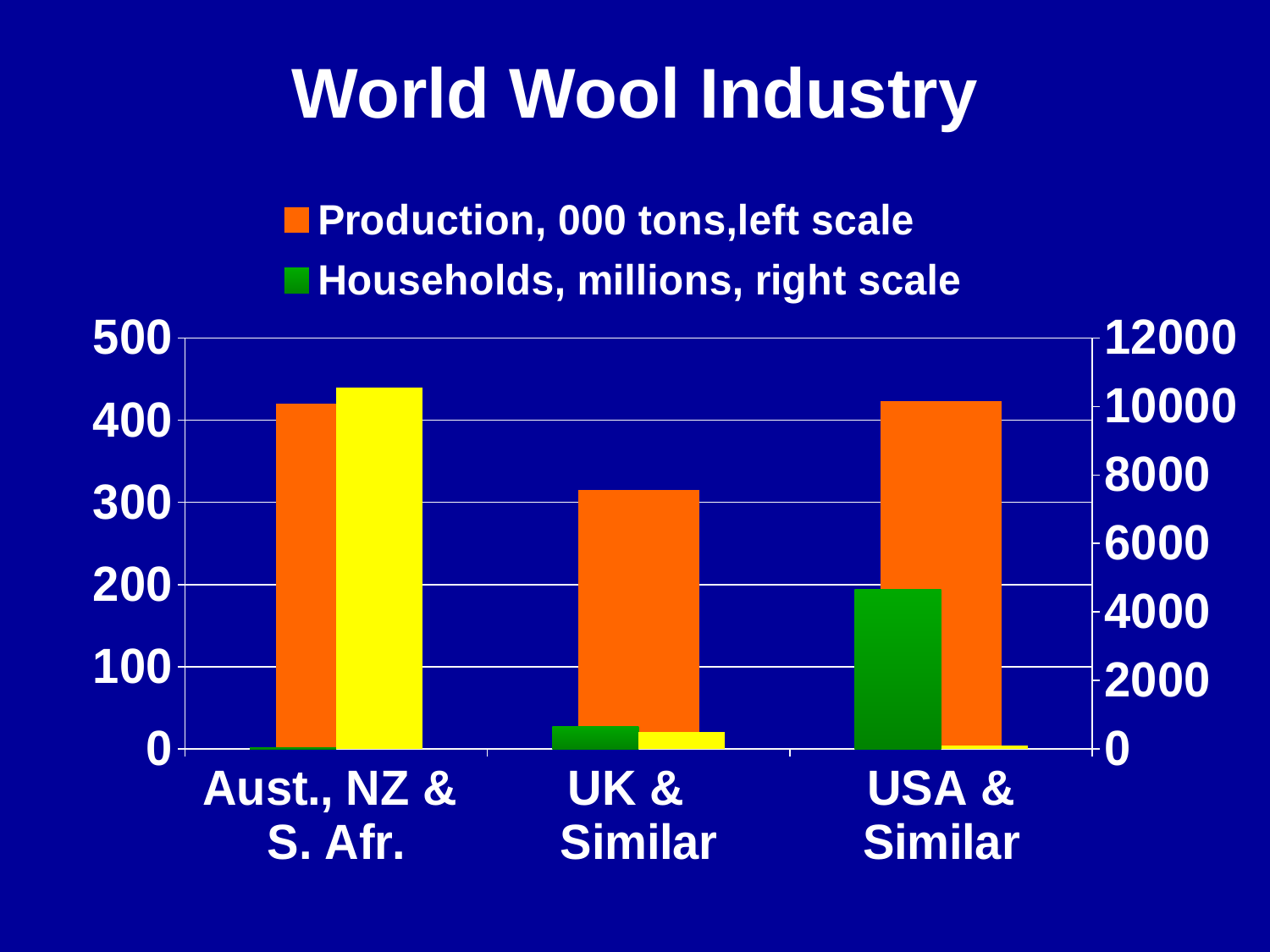
Which category has the lowest Production, 000 tons value? UK & Similar Which category has the highest Households, millions value? USA & Similar Is the Households value for USA & Similar greater or less than 4000 on the right scale? greater What colour represents the Production, 000 tons series in the legend? orange How many series does the legend list? 2 What kind of chart is shown on the slide? bar chart Is the Production value for UK & Similar greater or less than 300 on the left scale? greater Which is larger, the Households value for USA & Similar or for UK & Similar? USA & Similar How many categories are shown on the x axis? 3 What is the title of the chart? World Wool Industry Is the Production value for Aust., NZ & S. Afr. greater or less than 400 on the left scale? greater